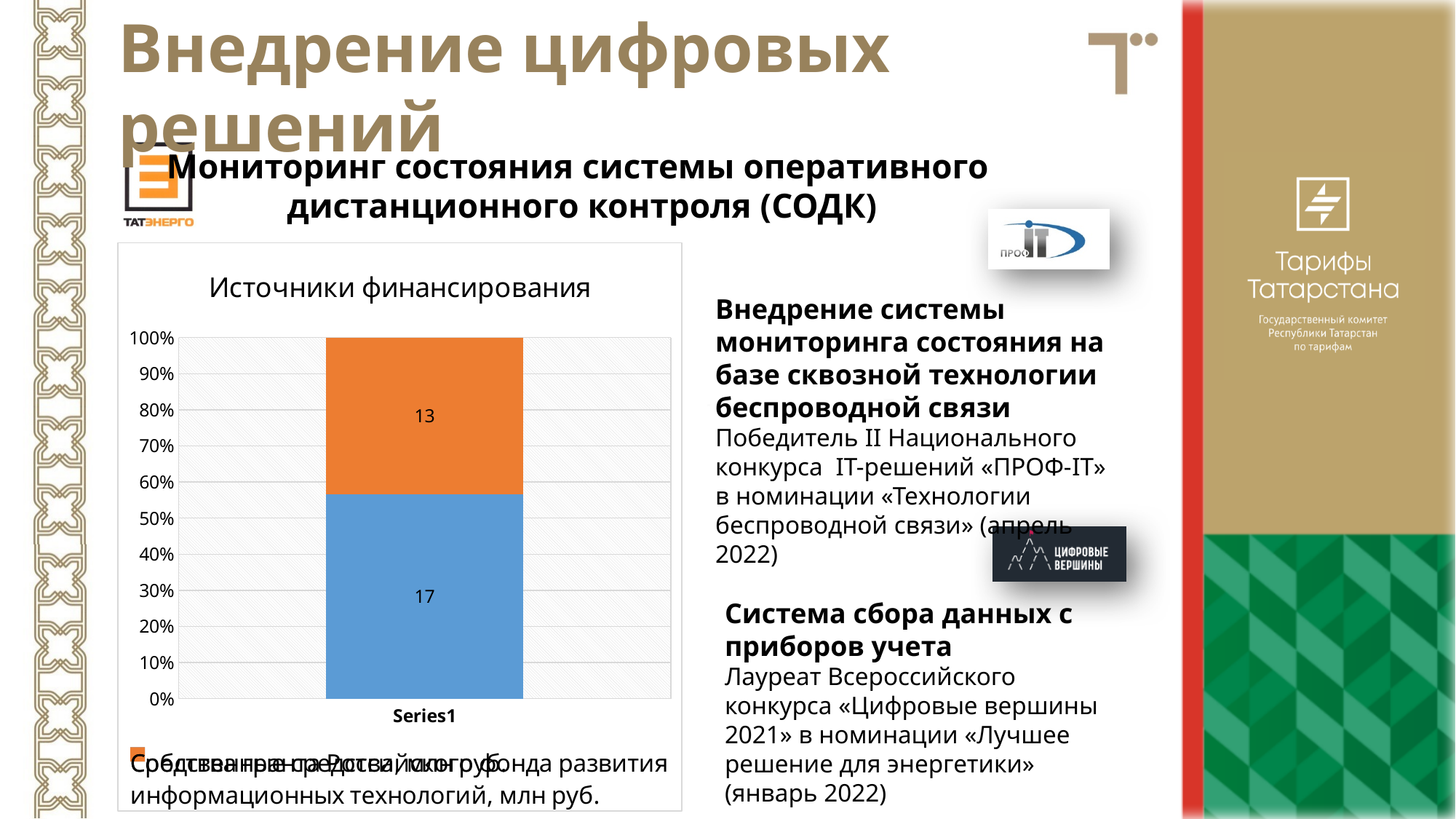
What is the title of the chart on the slide? Источники финансирования Which segment of the bar has the smallest labelled value? Orange (13) What value is labelled on the orange segment of the bar? 13 Is the top of the blue segment greater or less than 50% on the y axis? greater What is the category label shown on the x axis of the chart? Series1 Is the top of the blue segment greater or less than 60% on the y axis? less How many categories are shown on the x axis of the chart? 1 Which segment of the bar has the larger value, the blue one or the orange one? Blue What is the difference between the blue segment value and the orange segment value? 4 What kind of chart is shown under the title "Источники финансирования"? Stacked bar chart What is the total of the two labelled segments in the stacked bar? 30 What value is labelled on the blue segment of the bar? 17